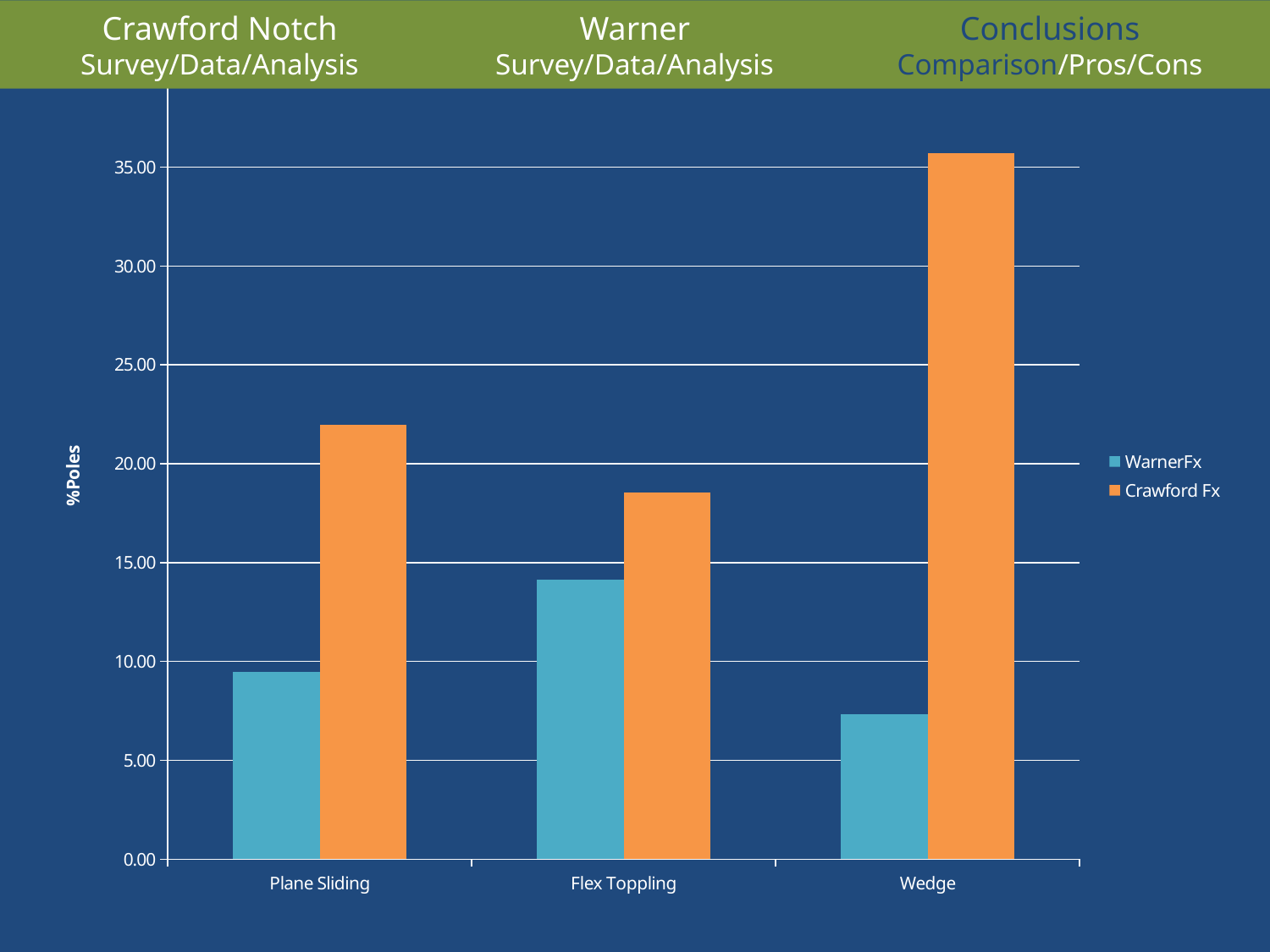
What is the label on the vertical axis of the chart? %Poles Is the Crawford Fx value for Wedge greater or less than 35.00? greater How many series does the chart's legend list? 2 Which category has the lowest WarnerFx value? Wedge What kind of chart is shown on the slide? bar chart Which category has the highest Crawford Fx value? Wedge Is the Crawford Fx value for Plane Sliding greater or less than 20.00? greater For Flex Toppling, which series has the larger value, WarnerFx or Crawford Fx? Crawford Fx Which category has the lowest Crawford Fx value? Flex Toppling Which category has the highest WarnerFx value? Flex Toppling Is the WarnerFx value for Plane Sliding greater or less than 10.00? less How many categories are shown on the x axis of the chart? 3